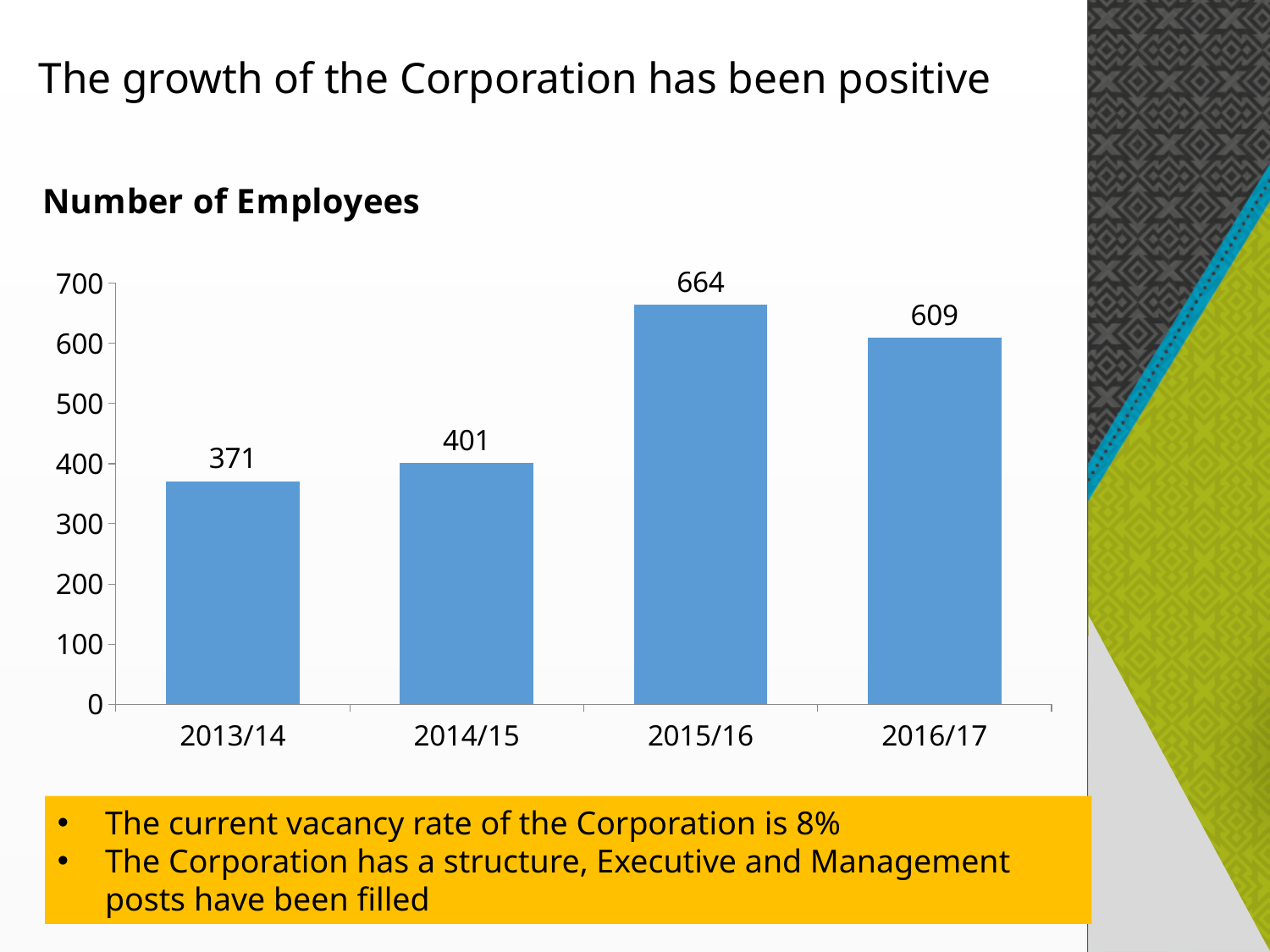
What kind of chart is shown on the slide? bar chart What is the number of employees in 2013/14? 371 Which year has the lowest number of employees? 2013/14 What is the number of employees in 2015/16? 664 What is the title of the chart? Number of Employees Which year has the highest number of employees? 2015/16 What is the number of employees in 2016/17? 609 What is the difference in the number of employees between 2014/15 and 2013/14? 30 How many years are shown on the chart? 4 Is the number of employees in 2014/15 greater or less than 500? less Which year has more employees, 2014/15 or 2016/17? 2016/17 What is the difference in the number of employees between 2015/16 and 2016/17? 55